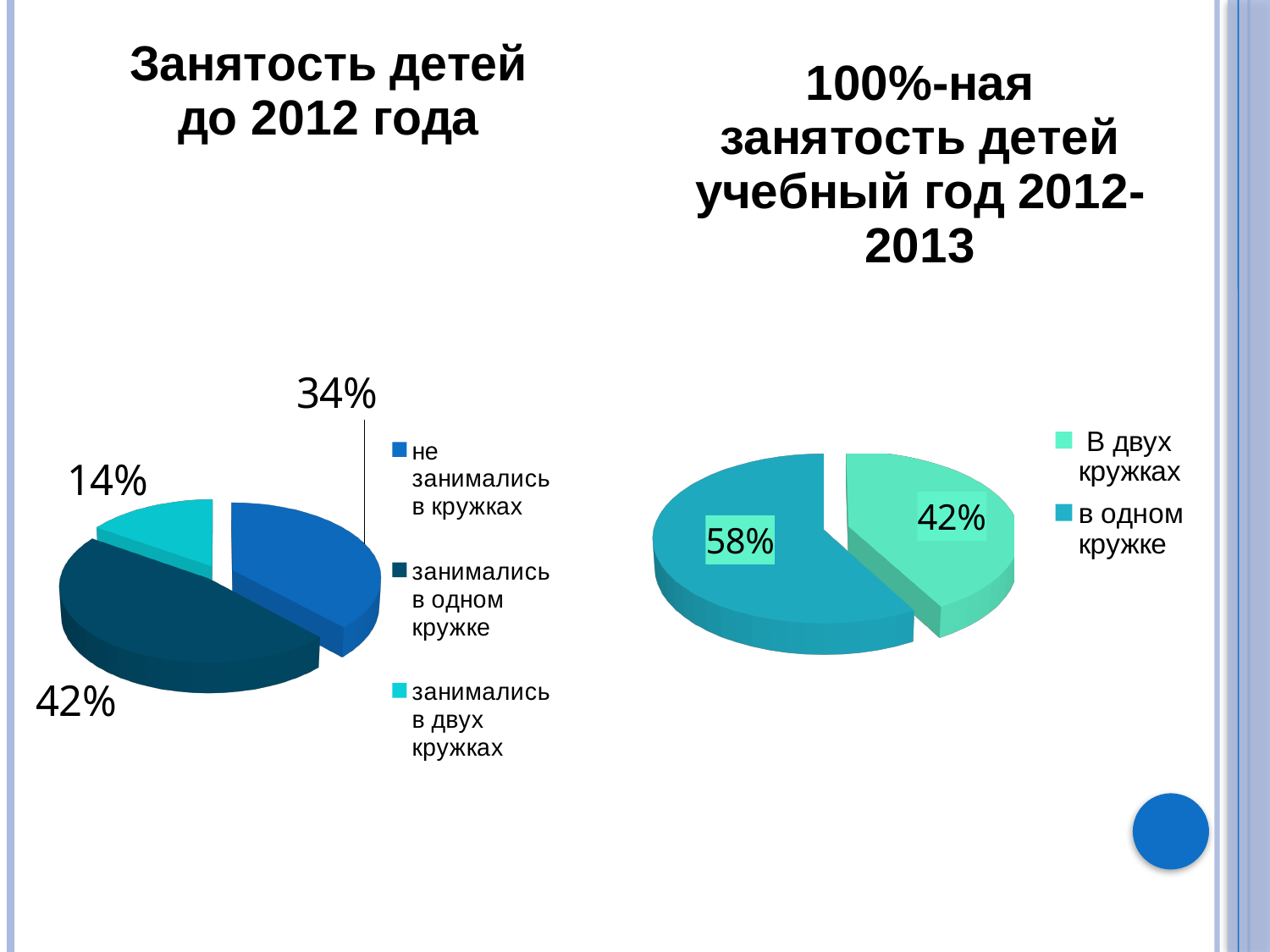
In the right chart '100%-ная занятость детей учебный год 2012-2013', what share of children attended two clubs ('В двух кружках')? 42% How many entries does the legend of the right chart '100%-ная занятость детей учебный год 2012-2013' list? 2 What type of chart is the right chart '100%-ная занятость детей учебный год 2012-2013'? pie chart In the left chart 'Занятость детей до 2012 года', which category has the largest slice? занимались в одном кружке In the right chart '100%-ная занятость детей учебный год 2012-2013', which is larger: the share for 'в одном кружке' or the share for 'В двух кружках'? в одном кружке In the left chart 'Занятость детей до 2012 года', what share of children attended one club ('занимались в одном кружке')? 42% In the left chart 'Занятость детей до 2012 года', what share of children did not attend any clubs ('не занимались в кружках')? 34% In the right chart '100%-ная занятость детей учебный год 2012-2013', what share of children attended one club ('в одном кружке')? 58% In the left chart 'Занятость детей до 2012 года', what is the difference between the share for 'занимались в одном кружке' and the share for 'не занимались в кружках'? 8% How many slices does the left chart 'Занятость детей до 2012 года' have? 3 In the left chart 'Занятость детей до 2012 года', which category has the smallest slice? занимались в двух кружках In the left chart 'Занятость детей до 2012 года', what share of children attended two clubs ('занимались в двух кружках')? 14%